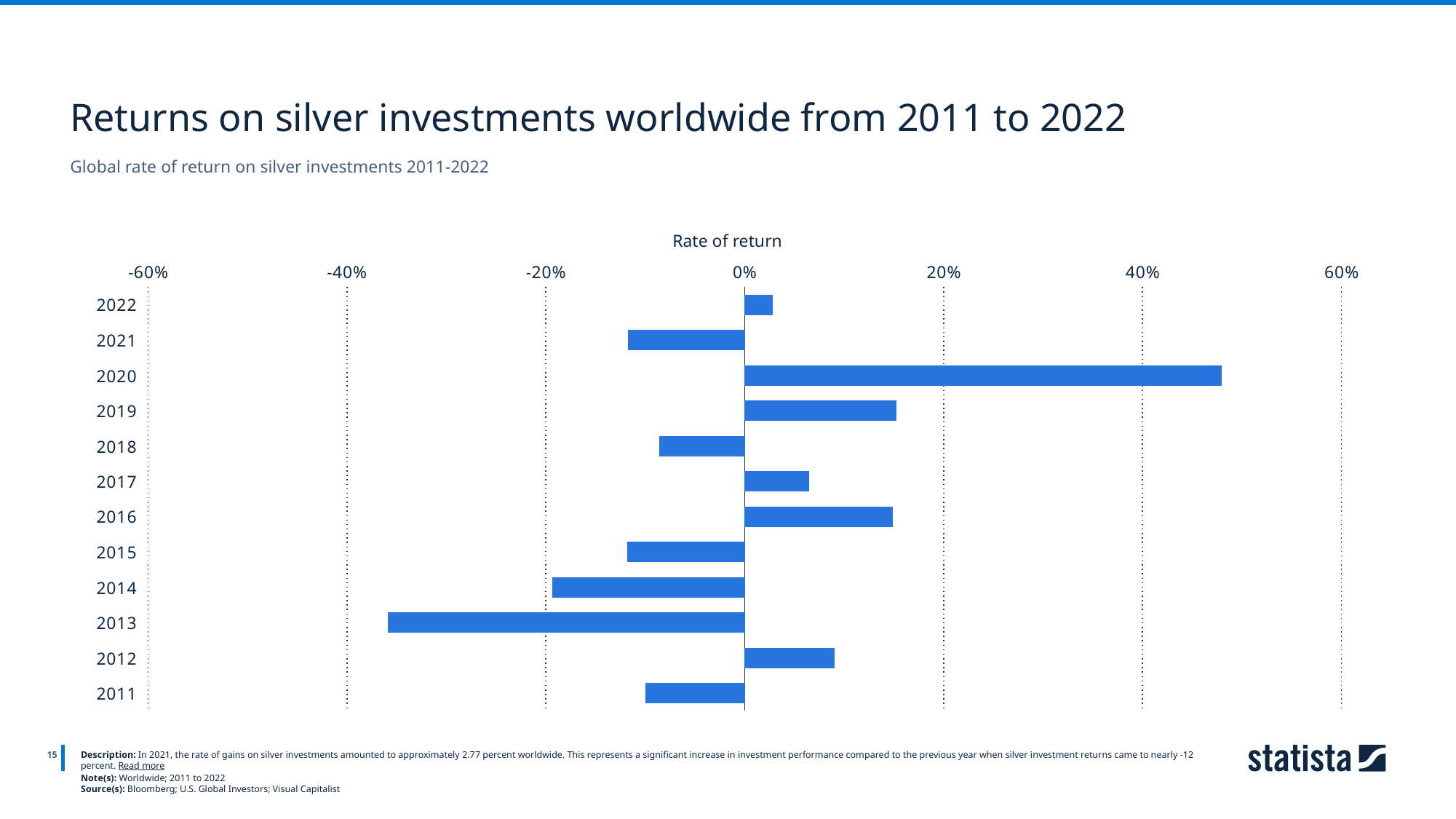
Is the rate of return for 2019 greater or less than 20%? less Which year had a higher rate of return, 2013 or 2014? 2014 Which year has the lowest rate of return on silver investments? 2013 What is the label shown above the value axis of the chart? Rate of return How many years are plotted in the chart? 12 Is the rate of return for 2013 greater or less than -20%? less Which year has the highest rate of return on silver investments? 2020 Which year had a higher rate of return, 2020 or 2019? 2020 Is the rate of return for 2020 greater or less than 40%? greater What is the title of the chart on the slide? Returns on silver investments worldwide from 2011 to 2022 What kind of chart is shown on the slide? bar chart